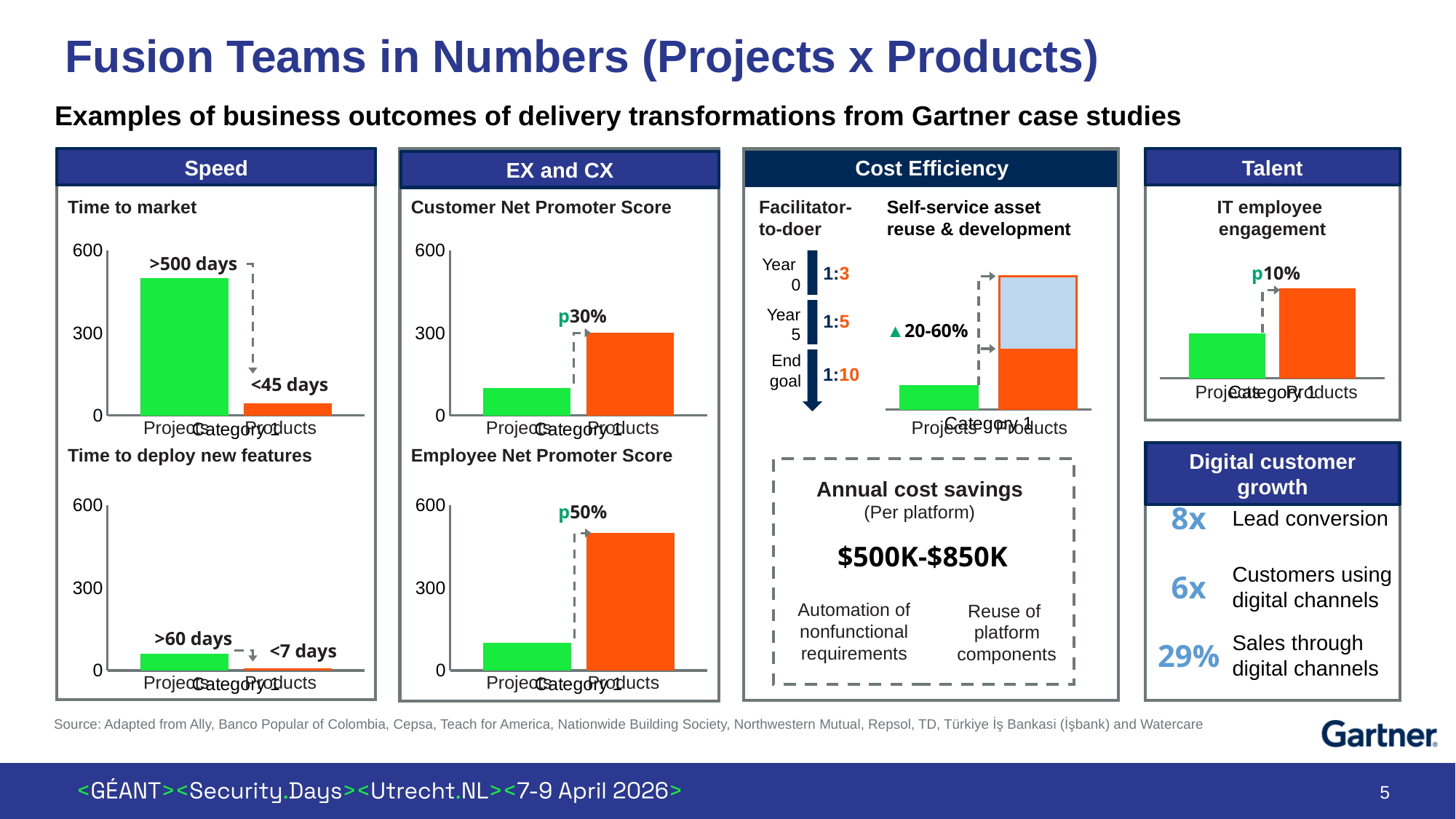
In the Employee Net Promoter Score chart, which category has the highest bar? Products In the Time to market chart, which is larger, the value for Projects or for Products? Projects In the Customer Net Promoter Score chart, what colour is the Products bar? orange In the Customer Net Promoter Score chart, is the value for Projects greater or less than 300? less In the Employee Net Promoter Score chart, is the value for Products greater or less than 300? greater In the Time to deploy new features chart, what is the value shown for Projects? >60 days In the Time to deploy new features chart, what is the value shown for Products? <7 days What kind of chart is the Time to market chart? bar chart In the Time to market chart, what is the value shown for Projects? >500 days In the Time to market chart, do the values rise or fall from Projects to Products? fall How many bars are plotted in the Time to deploy new features chart? 2 In the Time to market chart, what is the value shown for Products? <45 days